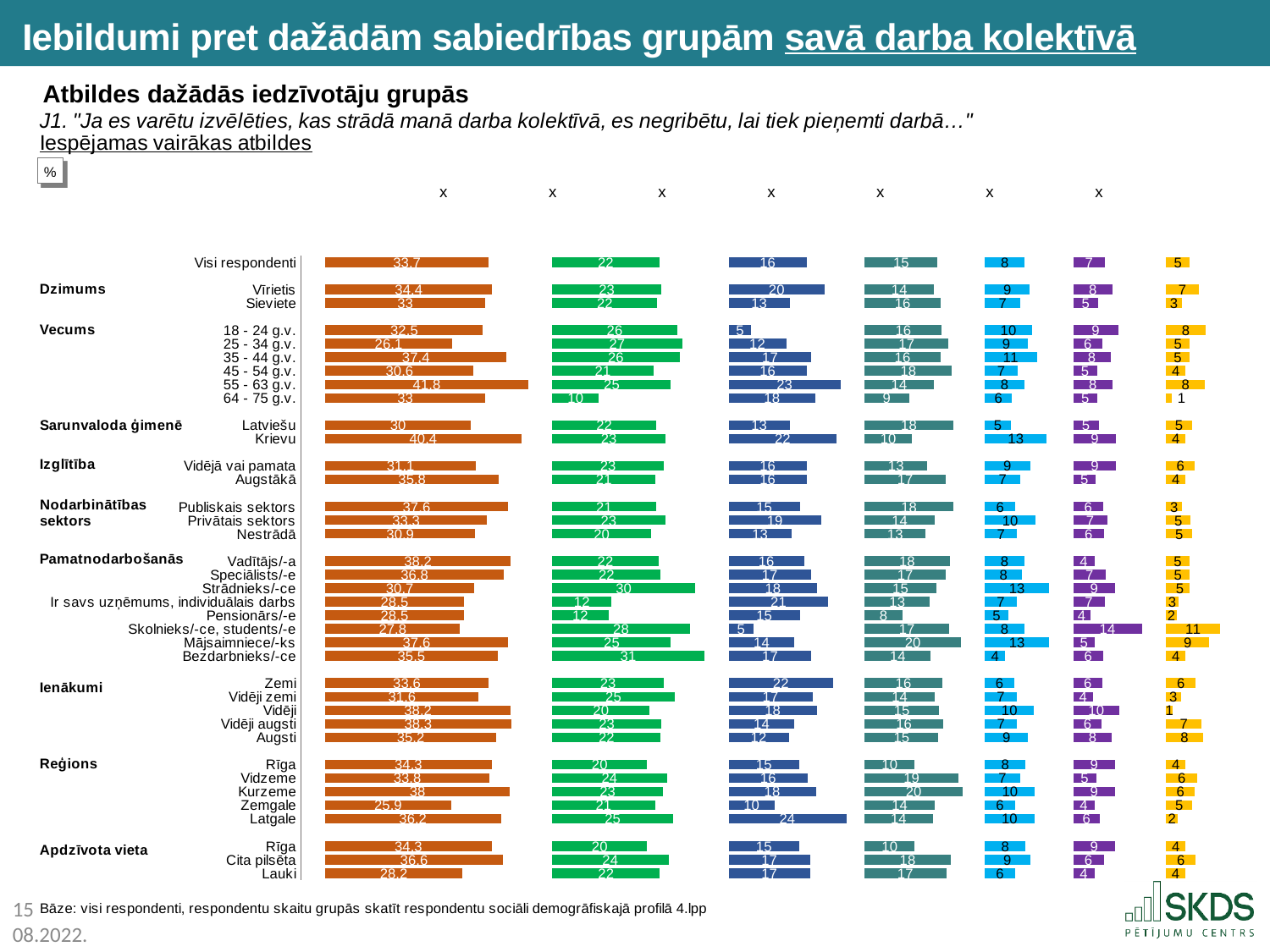
In the sixth chart from the left (purple), what is the value for Skolnieks/-ce, students/-e? 14 In the leftmost (orange) chart, which age group (Vecums) has the highest value? 55 - 63 g.v. In the second chart from the left (green), which Pamatnodarbošanās category has the highest value? Bezdarbnieks/-ce In the leftmost (orange) chart, which region (Reģions) has the lowest value? Zemgale In the leftmost (orange) chart, what is the difference between the values for Krievu and Latviešu? 10.4 In the rightmost (yellow) chart, which Pamatnodarbošanās category has the highest value? Skolnieks/-ce, students/-e In the fourth chart from the left (teal), what is the value for Mājsaimniece/-ks? 20 In the third chart from the left (blue), which is larger, the value for Vīrietis or for Sieviete? Vīrietis In the leftmost (orange) chart, what is the value for Visi respondenti? 33.7 What type of chart is used on this slide? Bar chart In the second chart from the left (green), what is the value for 64 - 75 g.v.? 10 In the third chart from the left (blue), what is the value for Latgale? 24